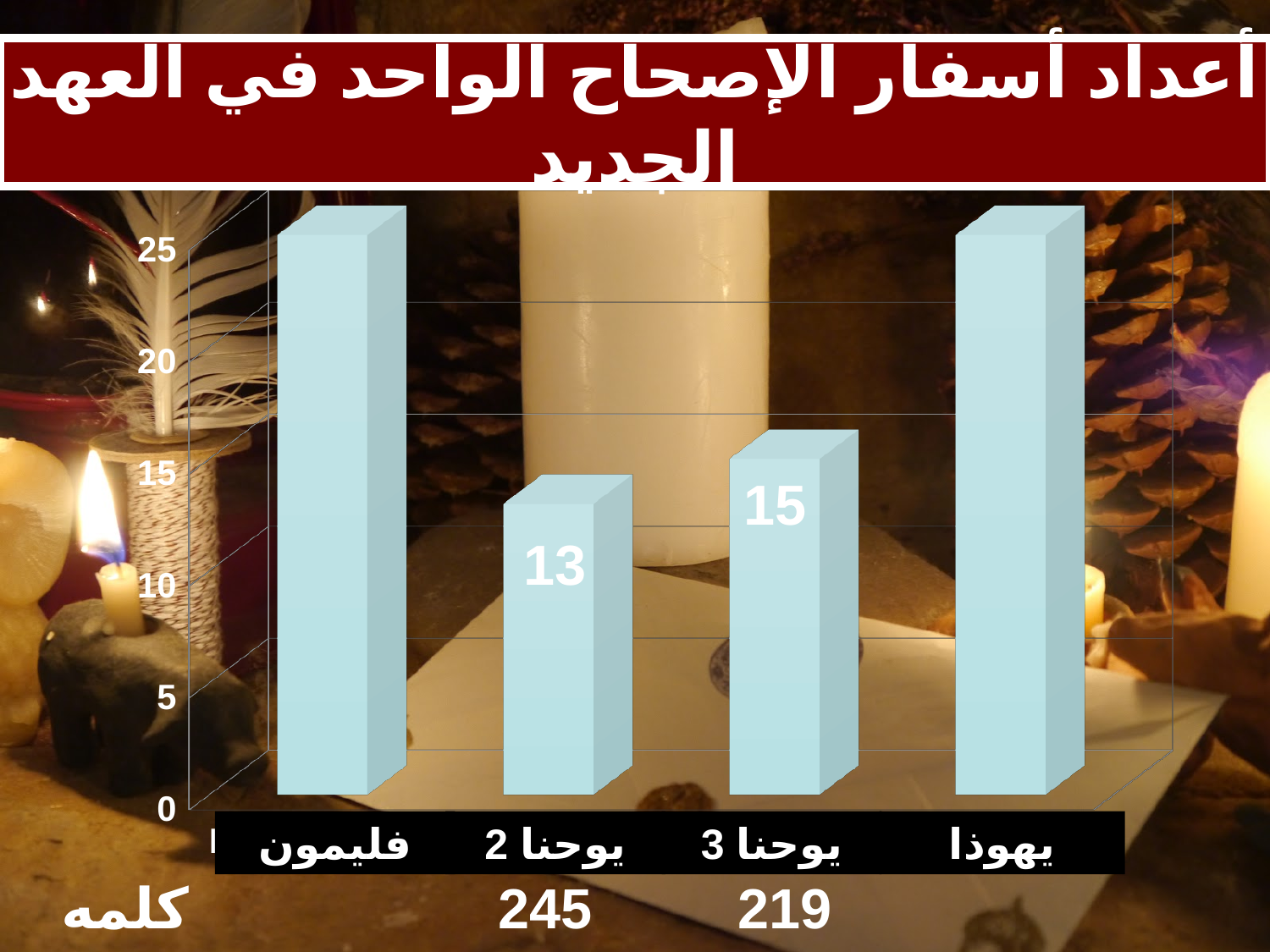
What kind of chart is shown on the slide? bar chart Which category has the lowest value? يوحنا 2 How many categories are shown on the chart? 4 Is the value for فليمون greater or less than 20? greater What is the difference between the values for يوحنا 3 and يوحنا 2? 2 Is the value for يهوذا greater or less than 20? greater What is the value for يوحنا 2? 13 What is the value for يوحنا 3? 15 What is the title of the slide? أعداد أسفار الإصحاح الواحد في العهد الجديد Is the value for يوحنا 2 greater or less than 15? less Which is larger, the value for فليمون or the value for يوحنا 2? فليمون Which is larger, the value for يوحنا 2 or the value for يوحنا 3? يوحنا 3